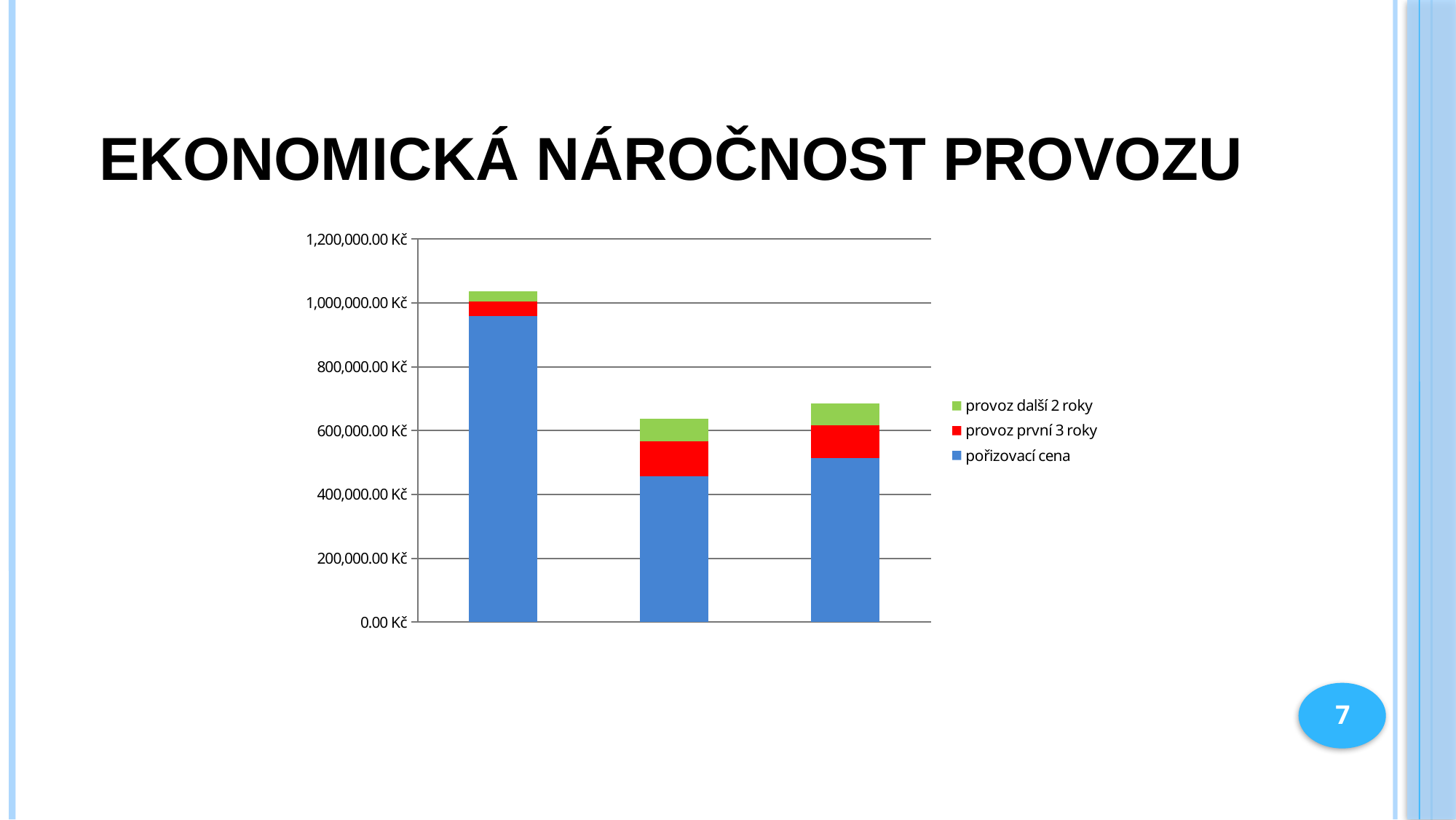
What kind of chart is shown on the slide? stacked bar chart Which bar has the larger pořizovací cena value, the left bar or the right bar? left Is the total of the middle bar greater or less than 600,000.00 Kč? greater Is the total of the left bar greater or less than 800,000.00 Kč? greater Which series is shown in blue in the chart? pořizovací cena Is the total of the right bar greater or less than 800,000.00 Kč? less How many series does the chart legend list? 3 Which bar has the greatest total height: the left, middle or right bar? left Which series is shown in green in the chart? provoz další 2 roky Which bar has the smallest total height: the left, middle or right bar? middle How many bars are plotted in the chart? 3